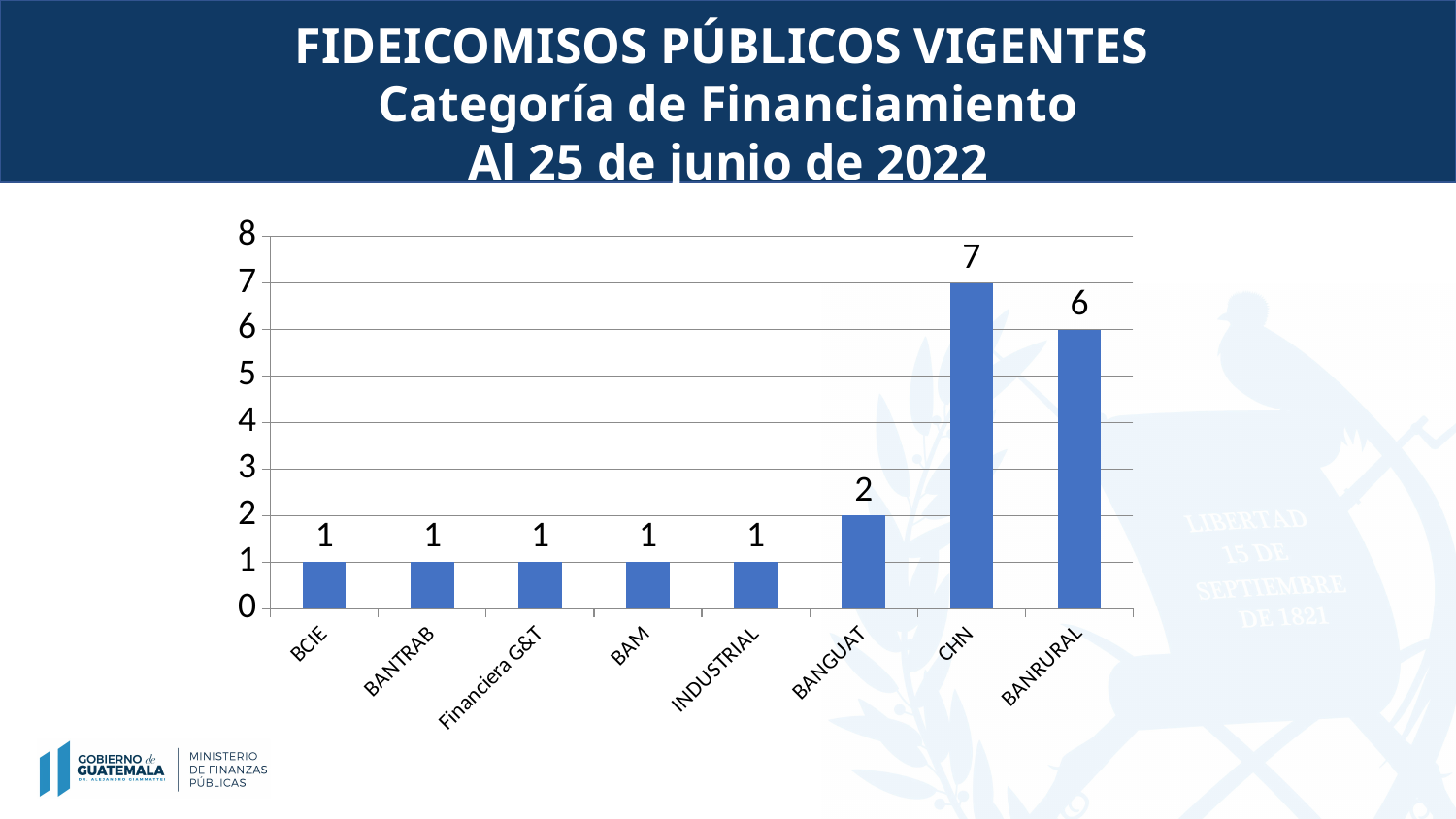
What is the value for BCIE? 1 What is the value for BANRURAL? 6 How many categories have a value of 1? 5 Is the value for CHN greater or less than 5? greater What kind of chart is shown on the slide? bar chart Which category has the highest value? CHN What is the value for CHN? 7 What is the value for BANGUAT? 2 How many categories are shown on the x axis? 8 What is the difference between the values for CHN and BANRURAL? 1 What is the difference between the values for BANRURAL and BANGUAT? 4 Which is larger, the value for BANGUAT or the value for INDUSTRIAL? BANGUAT